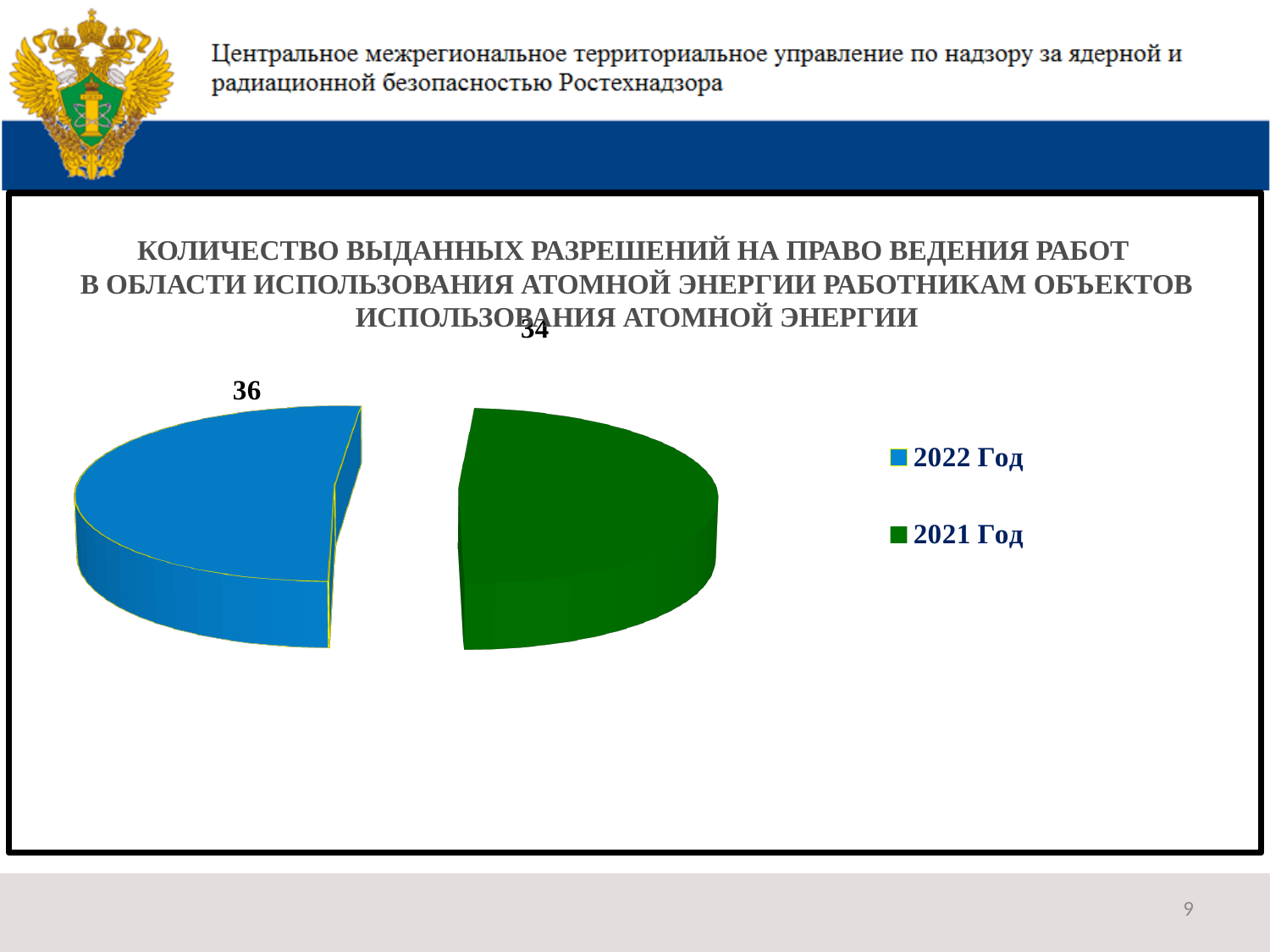
What is the value for 2021 Год? 34 Which year has the smaller value? 2021 Год What type of chart is shown on the slide? Pie chart What colour is the slice for 2022 Год? Blue How many entries does the legend list? 2 What is the difference between the values for 2022 Год and 2021 Год? 2 What colour is the slice for 2021 Год? Green Which year has the larger value? 2022 Год What is the value for 2022 Год? 36 What is the total of the two slices in the pie chart? 70 Is the value for 2022 Год larger or smaller than the value for 2021 Год? Larger How many slices does the pie chart have? 2